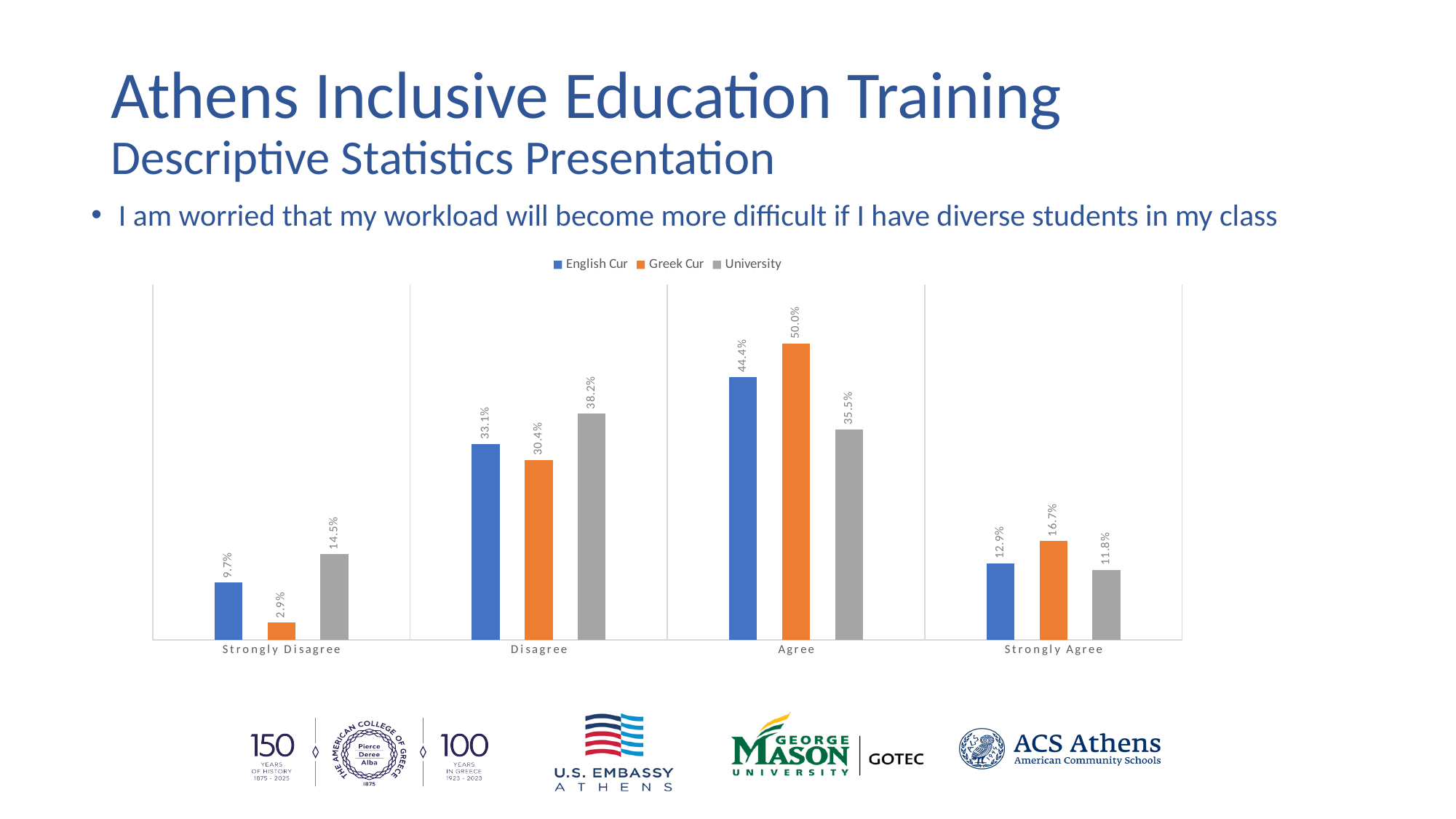
What is the difference between the University values for Strongly Disagree and Strongly Agree? 2.7% Which category has the highest value for the English Cur series? Agree What is the value for English Cur in the Strongly Disagree category? 9.7% What is the value for Greek Cur in the Agree category? 50.0% How many series does the legend list? 3 What is the difference between the Greek Cur and University values in the Agree category? 14.5% In the Strongly Agree category, which is larger: English Cur or Greek Cur? Greek Cur Which series is shown in orange in the legend? Greek Cur What kind of chart is shown on the slide? Bar chart What is the value for University in the Disagree category? 38.2% Which category has the lowest value for the Greek Cur series? Strongly Disagree How many categories are shown on the x axis? 4